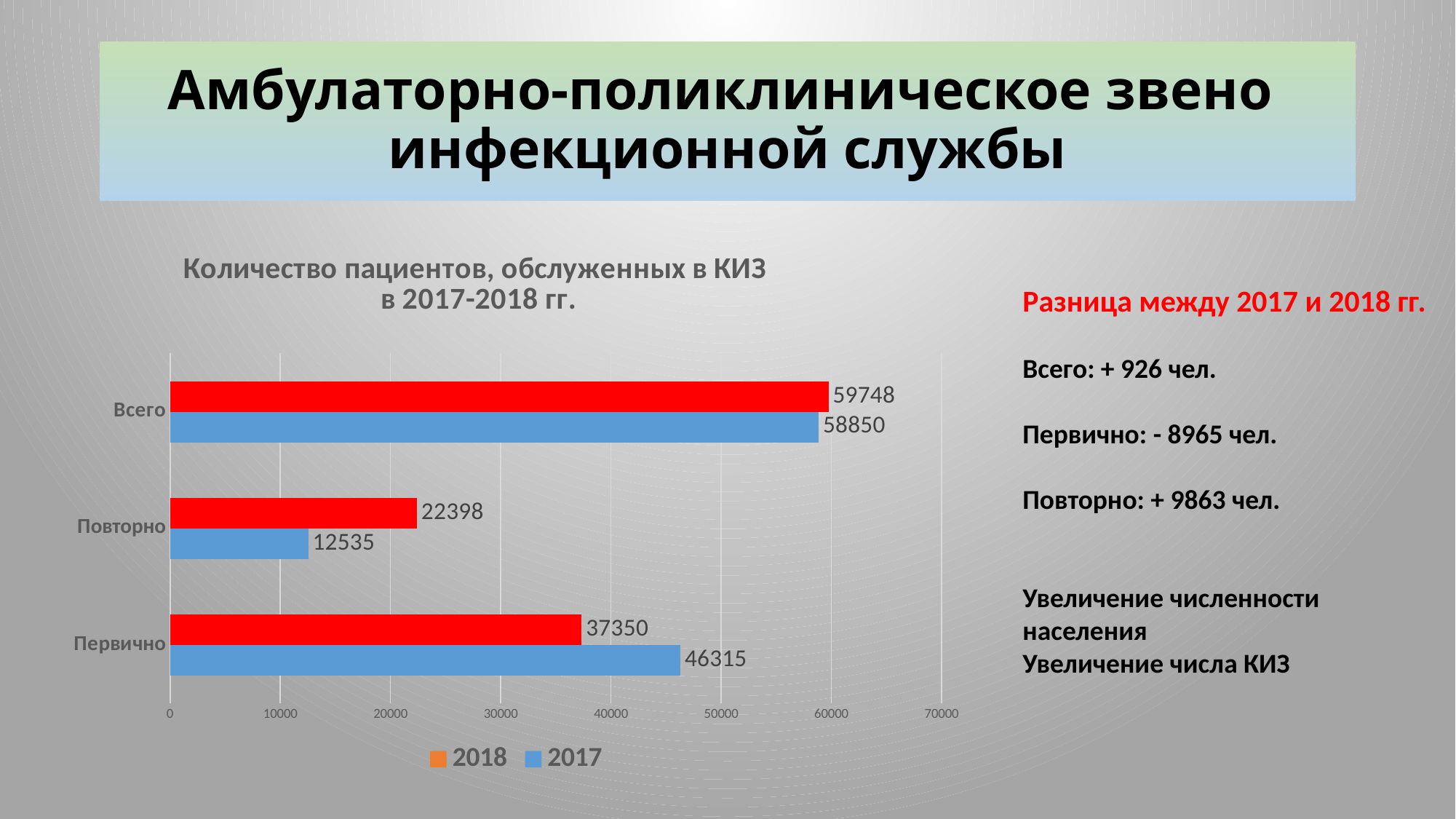
How many series does the legend list? 2 Which is larger for Первично: the 2017 value or the 2018 value? 2017 What is the value for 2017 in the Первично category? 46315 What kind of chart is shown on the slide? Bar chart How many categories are shown on the chart? 3 What is the value for 2018 in the Повторно category? 22398 What is the value for 2018 in the Всего category? 59748 Which category has the highest value for 2018? Всего What is the difference between the 2018 and 2017 values for Повторно? 9863 What is the value for 2017 in the Всего category? 58850 Which category has the lowest value for 2017? Повторно What is the difference between the 2017 and 2018 values for Первично? 8965